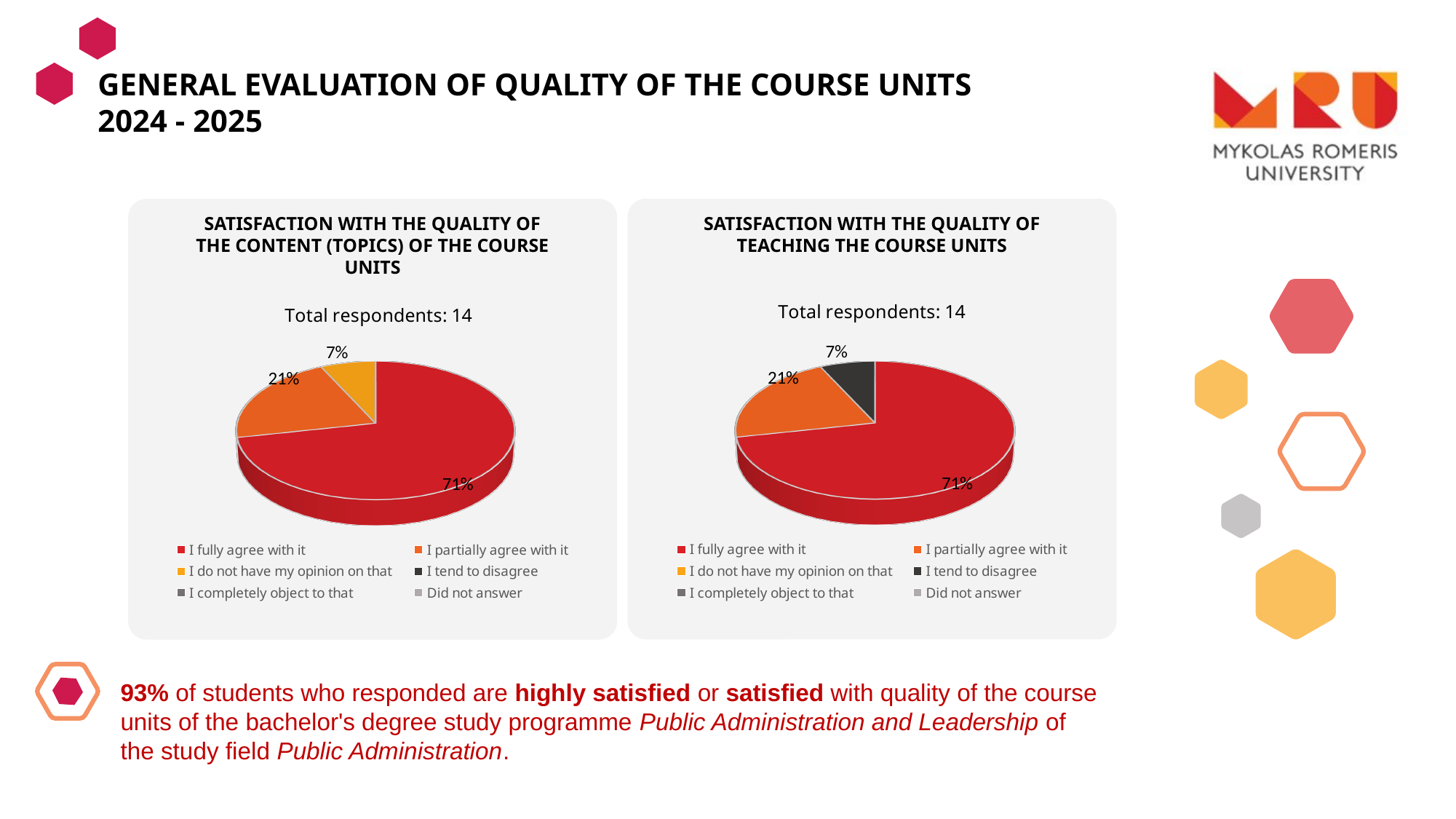
In the chart titled "Satisfaction with the quality of the content (topics) of the course units", what share of respondents chose "I partially agree with it"? 21% In the chart titled "Satisfaction with the quality of the content (topics) of the course units", which response has the smallest slice? I do not have my opinion on that In the chart titled "Satisfaction with the quality of the content (topics) of the course units", what share of respondents chose "I fully agree with it"? 71% In the chart titled "Satisfaction with the quality of the content (topics) of the course units", what share of respondents chose "I do not have my opinion on that"? 7% In the chart titled "Satisfaction with the quality of teaching the course units", what share of respondents chose "I tend to disagree"? 7% In the chart titled "Satisfaction with the quality of teaching the course units", what share of respondents chose "I partially agree with it"? 21% In the chart titled "Satisfaction with the quality of teaching the course units", which is larger: "I partially agree with it" or "I tend to disagree"? I partially agree with it How many total respondents are reported for the chart titled "Satisfaction with the quality of teaching the course units"? 14 In the chart titled "Satisfaction with the quality of the content (topics) of the course units", what is the difference in percentage points between "I fully agree with it" and "I partially agree with it"? 50 How many entries does the legend list in the chart titled "Satisfaction with the quality of the content (topics) of the course units"? 6 What type of chart is used in the chart titled "Satisfaction with the quality of teaching the course units"? Pie chart In the chart titled "Satisfaction with the quality of teaching the course units", which response has the largest slice? I fully agree with it